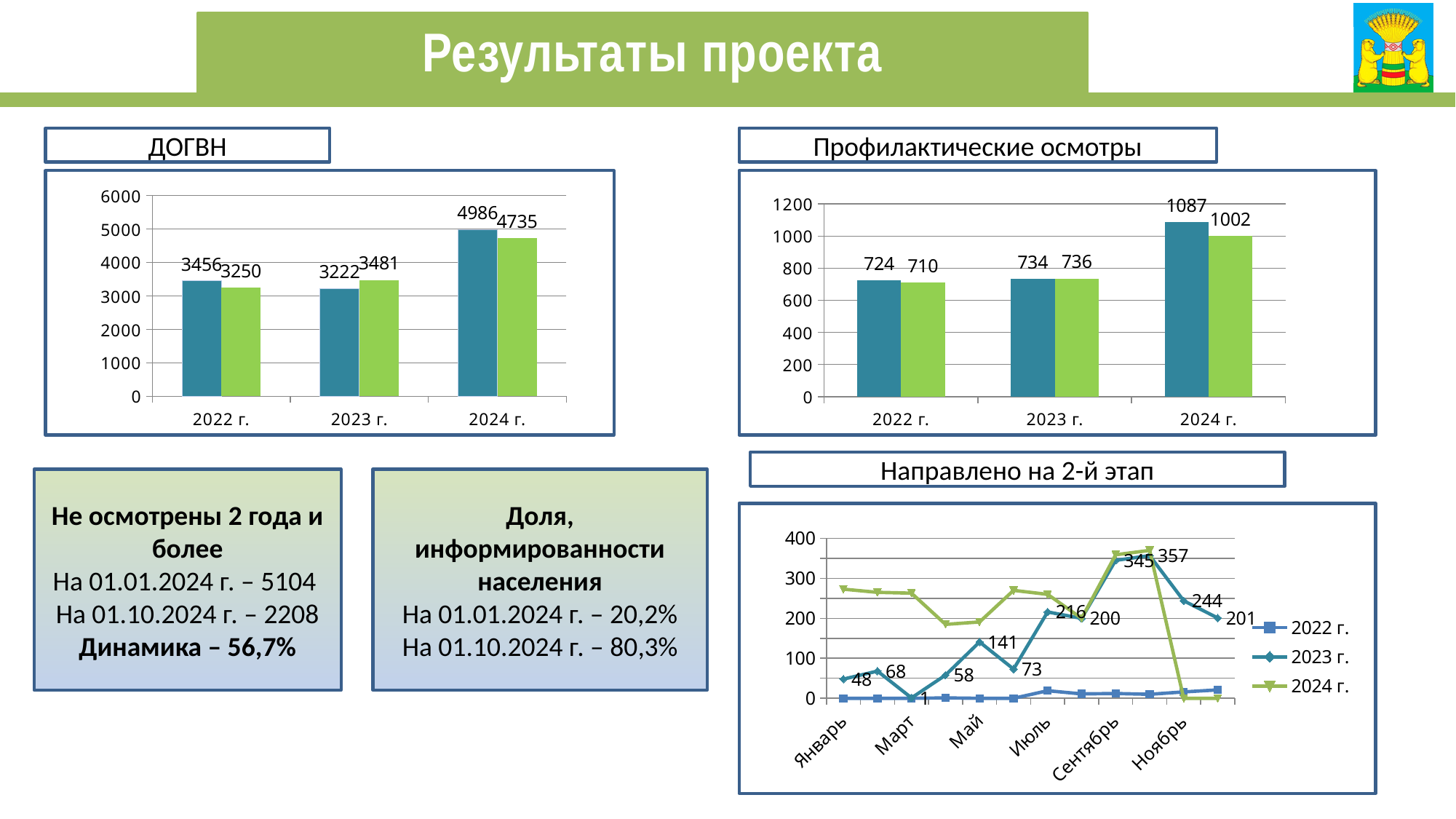
In the Профилактические осмотры chart, what is the value of the dark blue bar for 2024 г.? 1087 In the ДОГВН chart, what is the value of the green bar for 2023 г.? 3481 In the Направлено на 2-й этап chart, is the value for 2024 г. in Январь greater or less than 200? greater What kind of chart is the Направлено на 2-й этап chart? line chart In the ДОГВН chart, what is the value of the dark blue bar for 2024 г.? 4986 In the Профилактические осмотры chart, which year has the lowest green bar? 2022 г. How many series does the legend of the Направлено на 2-й этап chart list? 3 In the ДОГВН chart, what is the difference between the two bars for 2024 г.? 251 What kind of chart is the ДОГВН chart? bar chart In the Профилактические осмотры chart, what is the difference between the two bars for 2024 г.? 85 In the ДОГВН chart, which year has the highest dark blue bar? 2024 г. In the Профилактические осмотры chart, what is the value of the green bar for 2022 г.? 710